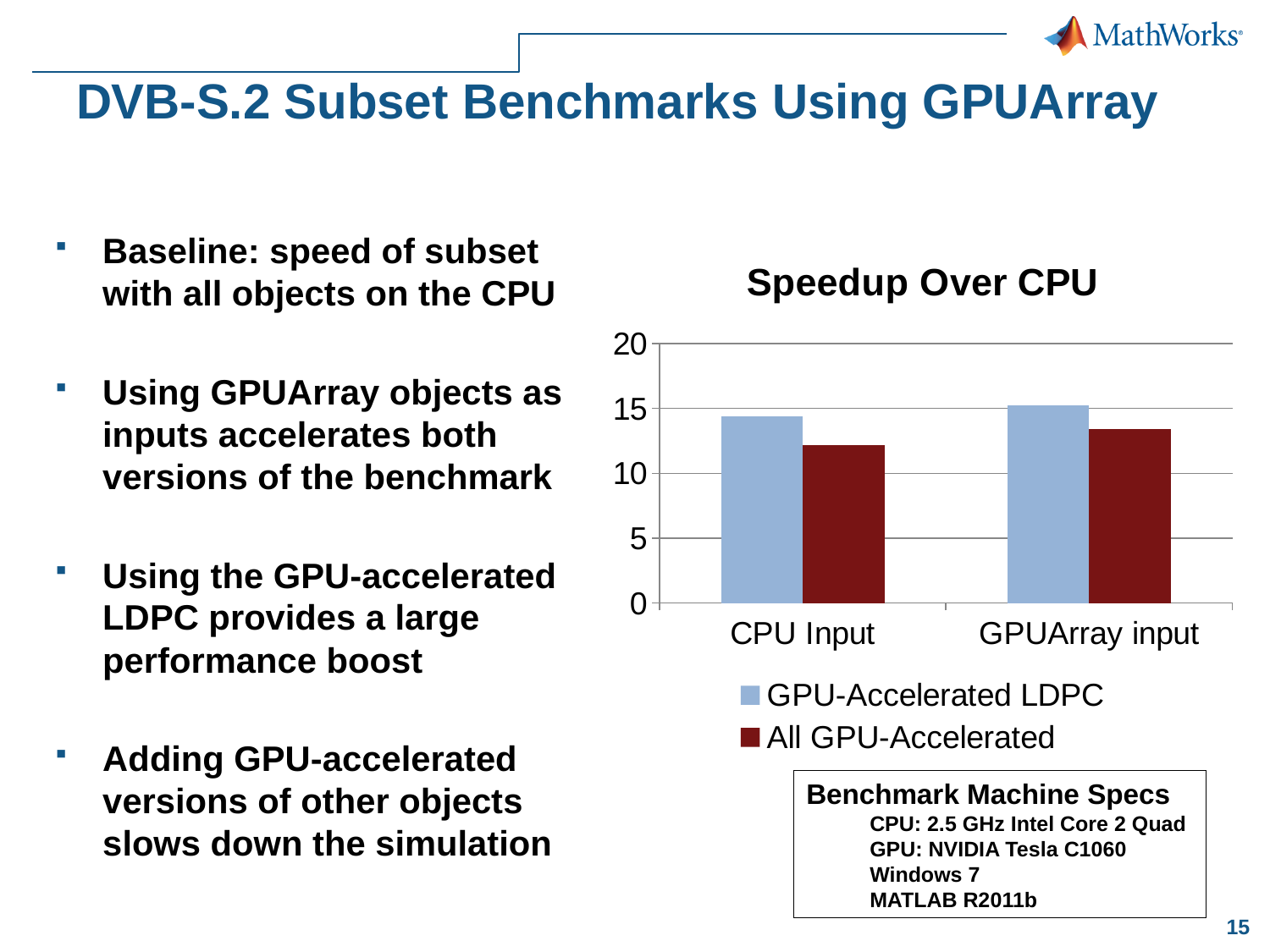
Which bar in the chart is the highest? GPU-Accelerated LDPC at GPUArray input Does the speedup for the GPU-Accelerated LDPC series rise or fall from CPU Input to GPUArray input? rise How many series does the chart legend list? 2 For CPU Input, which series has the larger speedup: GPU-Accelerated LDPC or All GPU-Accelerated? GPU-Accelerated LDPC Is the value for All GPU-Accelerated at GPUArray input greater or less than 15? less What is the title of the chart? Speedup Over CPU Which bar in the chart is the lowest? All GPU-Accelerated at CPU Input What type of chart is shown on the slide? bar chart How many categories are shown on the x axis of the chart? 2 Which series is shown in dark red in the chart? All GPU-Accelerated For GPUArray input, which series has the larger speedup: GPU-Accelerated LDPC or All GPU-Accelerated? GPU-Accelerated LDPC Is the value for All GPU-Accelerated at CPU Input greater or less than 10? greater